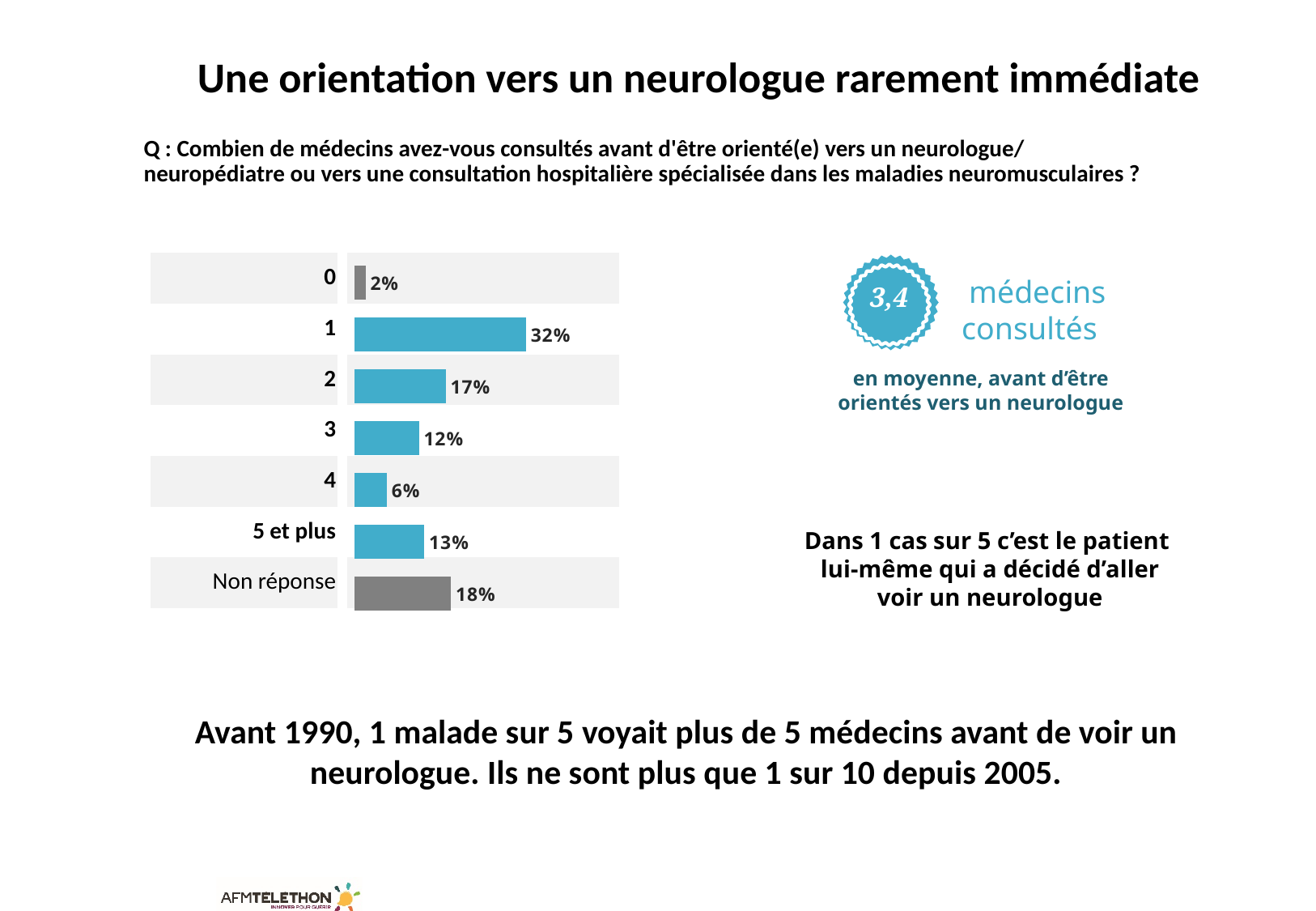
What is the difference between the values for '5 et plus' and '4'? 7% Which category has the highest percentage? 1 What type of chart is shown on the slide? Bar chart Which bar in the chart is coloured grey rather than blue, apart from the '0' bar? Non réponse What is the difference between the values for '1' and '2'? 15% How many categories are shown in the chart? 7 Which is larger, the value for '3' or the value for '4'? 3 What percentage of respondents consulted 1 doctor before being referred to a neurologist? 32% What is the value for '5 et plus'? 13% What percentage is shown for 'Non réponse'? 18% Which category has the lowest percentage? 0 What is the value shown for the category '2'? 17%